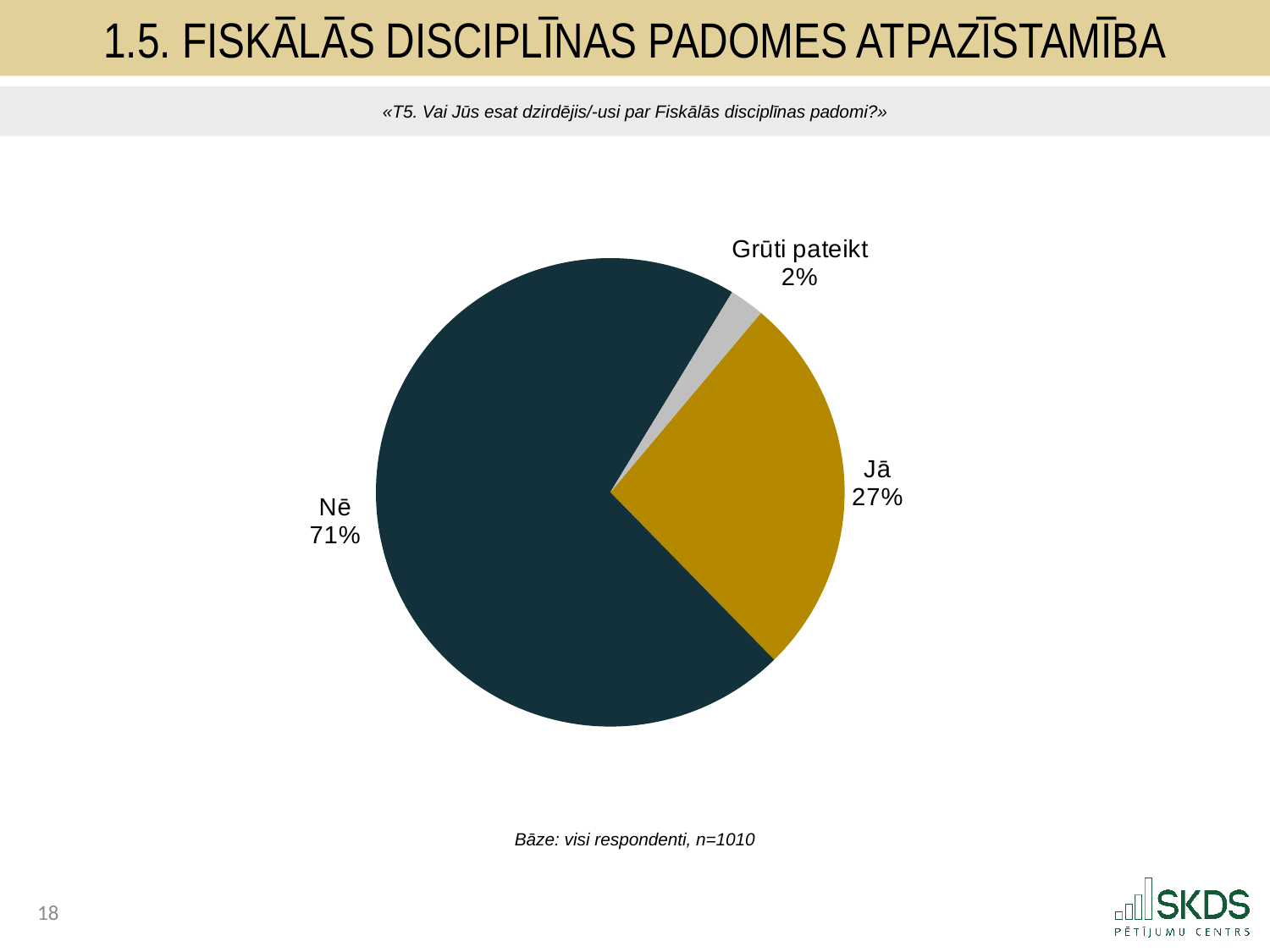
What is the difference in percentage points between "Nē" and "Jā"? 44 What is the combined share of "Jā" and "Grūti pateikt"? 29% What kind of chart is shown on the slide? pie chart What percentage of respondents answered "Grūti pateikt"? 2% What is the base (n) of respondents stated below the chart? n=1010 Which is larger, the share for "Jā" or the share for "Grūti pateikt"? Jā What percentage of respondents answered "Nē"? 71% What percentage of respondents answered "Jā"? 27% Which response has the largest share of the pie? Nē What is the survey question quoted above the chart? «T5. Vai Jūs esat dzirdējis/-usi par Fiskālās disciplīnas padomi?» How many slices does the pie chart have? 3 Which response has the smallest share of the pie? Grūti pateikt